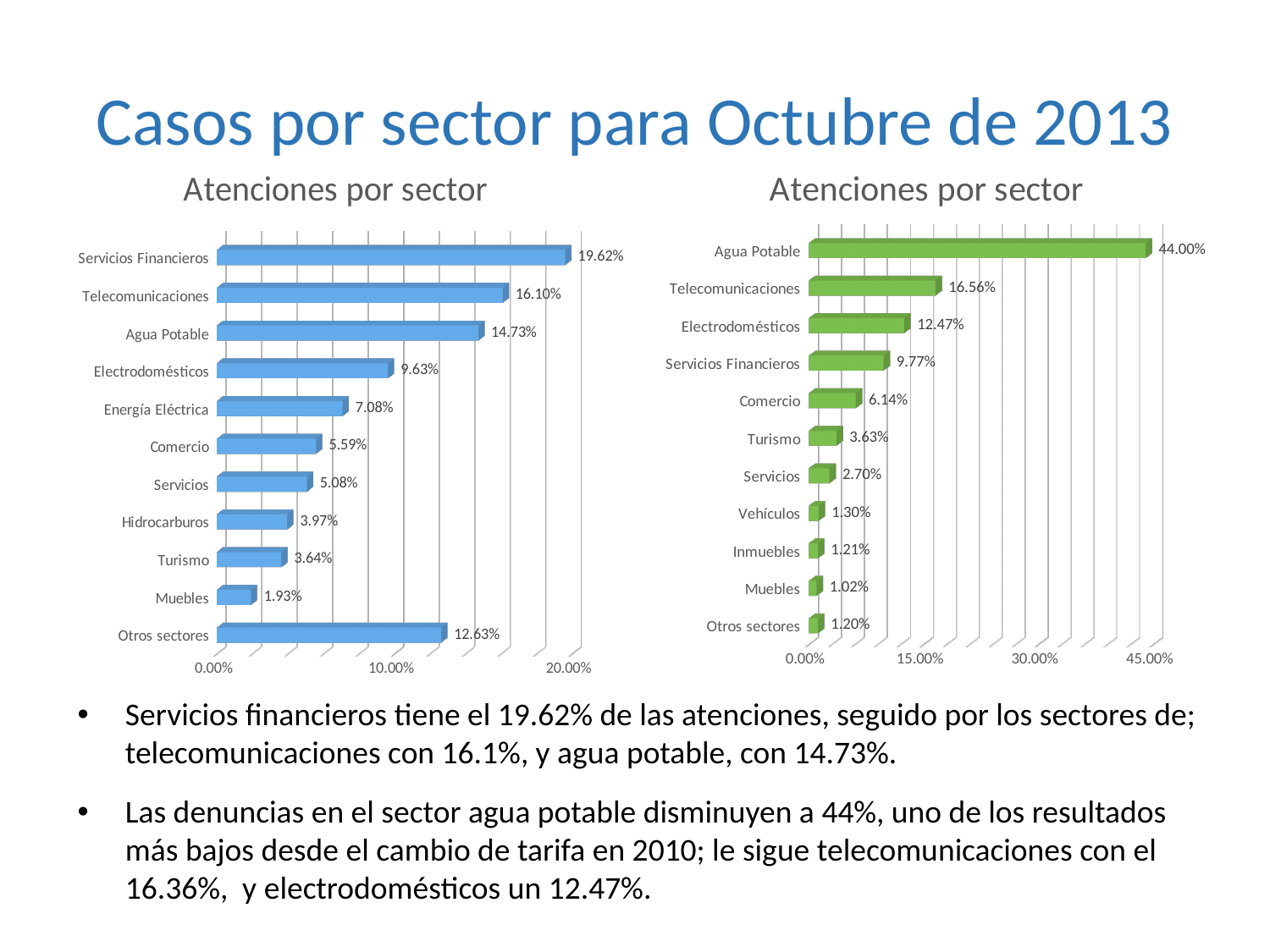
How many categories are shown in the right chart? 11 In the left chart, is the value for Energía Eléctrica greater or less than 10.00%? less In the right chart, which is larger, Comercio or Turismo? Comercio In the right chart, what is the value for Agua Potable? 44.00% In the left chart, what is the value for Servicios Financieros? 19.62% What is the title of the right chart? Atenciones por sector In the left chart, what is the difference between Telecomunicaciones and Agua Potable? 1.37% In the left chart, what is the value for Otros sectores? 12.63% What kind of chart is the left chart? bar chart In the right chart, which category has the highest value? Agua Potable In the right chart, what is the value for Electrodomésticos? 12.47% In the left chart, which category has the lowest value? Muebles